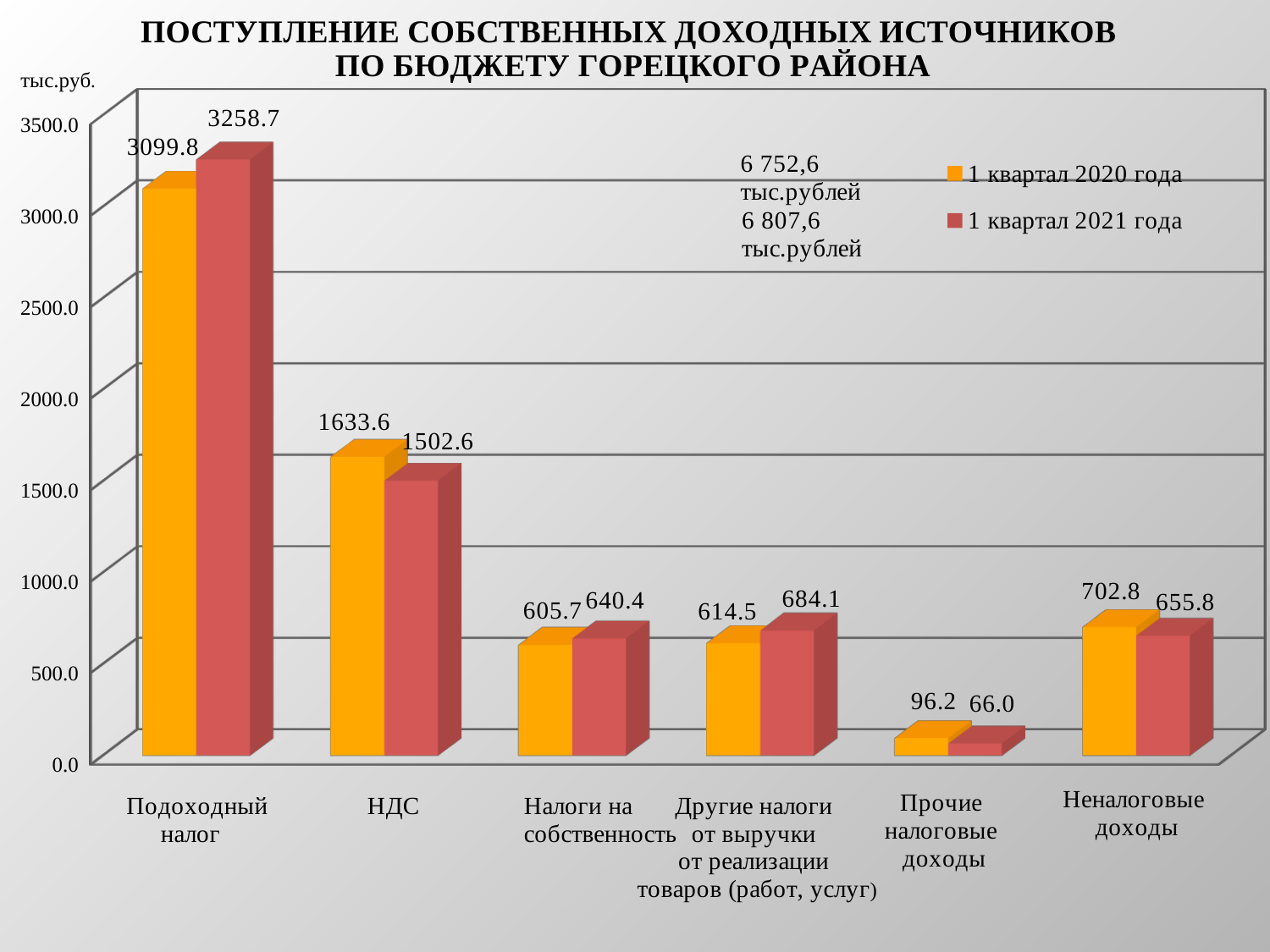
What kind of chart is shown on the slide? Bar chart How many series does the legend list? 2 What is the value for Прочие налоговые доходы in the series 1 квартал 2021 года? 66.0 What is the value for НДС in the series 1 квартал 2021 года? 1502.6 What is the value for Подоходный налог in the series 1 квартал 2020 года? 3099.8 What is the difference between the 1 квартал 2021 года and 1 квартал 2020 года values for Подоходный налог? 158.9 Which category has the lowest value in the series 1 квартал 2020 года? Прочие налоговые доходы Which category has the highest value in the series 1 квартал 2021 года? Подоходный налог What unit is shown at the top of the vertical axis? тыс.руб. For НДС, which series has the larger value: 1 квартал 2020 года or 1 квартал 2021 года? 1 квартал 2020 года What is the value for Неналоговые доходы in the series 1 квартал 2020 года? 702.8 How many categories are shown on the x axis? 6